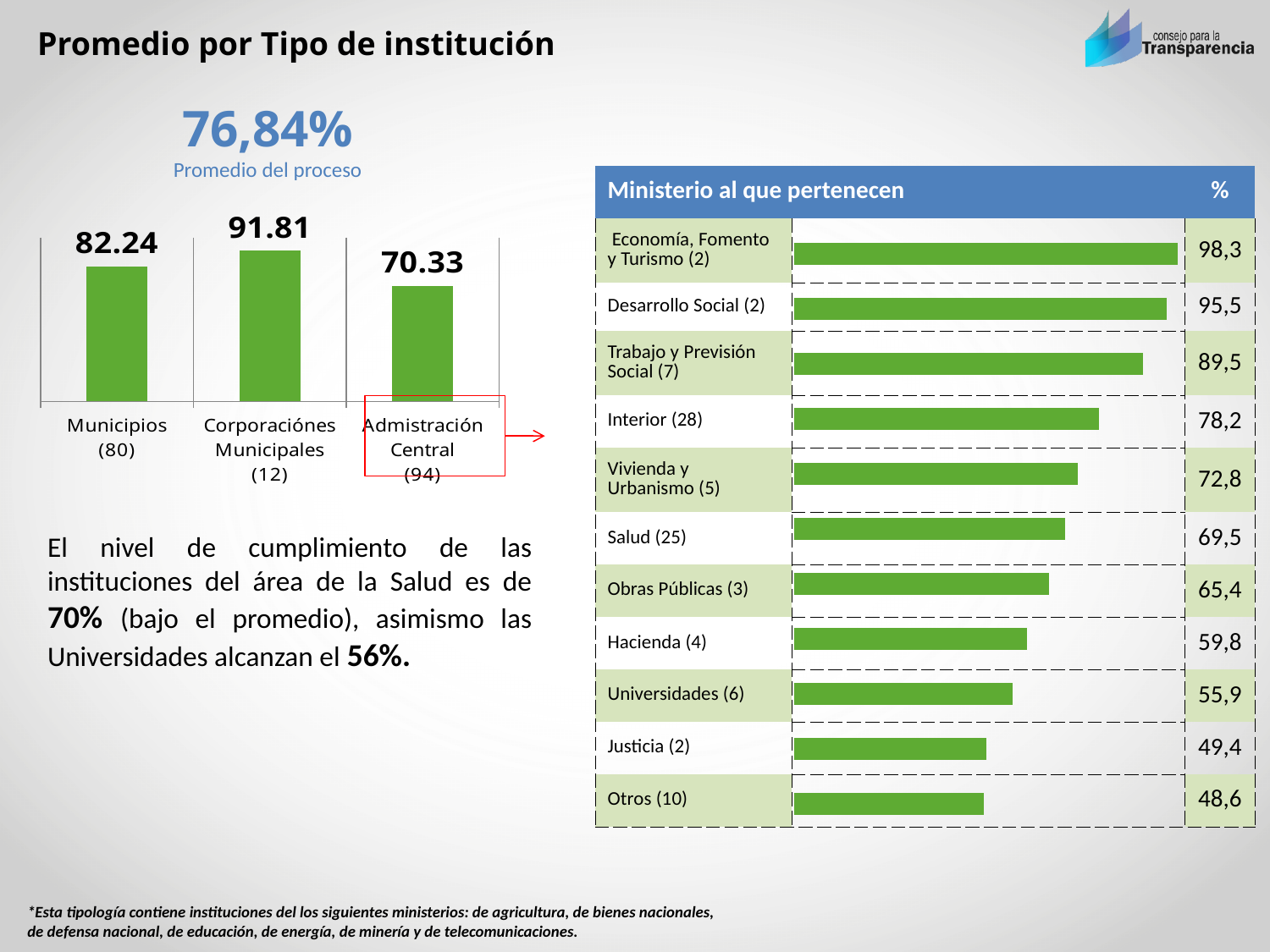
In the bar chart on the left, what is the difference between the values for Corporaciónes Municipales (12) and Admistración Central (94)? 21.48 In the bar chart on the left, which category has the lowest value? Admistración Central (94) In the 'Ministerio al que pertenecen' chart, what is the difference between the values for Desarrollo Social (2) and Justicia (2)? 46,1 In the 'Ministerio al que pertenecen' chart, which ministry has the lowest percentage? Otros (10) In the bar chart on the left, what is the value for Municipios (80)? 82.24 In the bar chart on the left, which category has the highest value? Corporaciónes Municipales (12) What kind of chart is shown on the left of the slide? bar chart In the 'Ministerio al que pertenecen' chart, which is larger: the value for Salud (25) or the value for Hacienda (4)? Salud (25) In the bar chart on the left, how many categories are shown? 3 In the 'Ministerio al que pertenecen' chart, what is the percentage for Interior (28)? 78,2 In the 'Ministerio al que pertenecen' chart, which ministry has the highest percentage? Economía, Fomento y Turismo (2) In the 'Ministerio al que pertenecen' chart, how many ministries are listed? 11